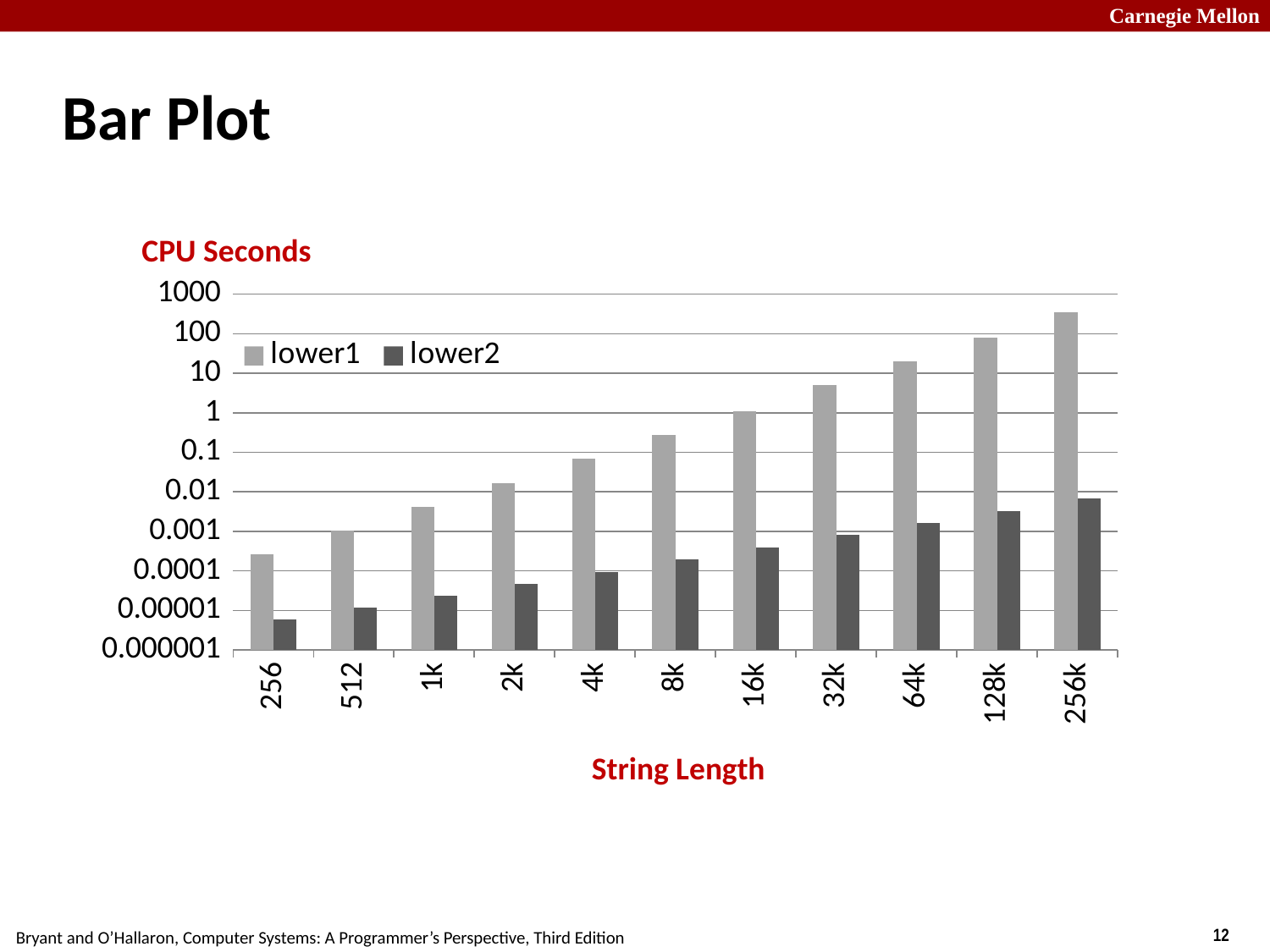
Is the lower1 value for string length 256k greater or less than 100? greater What is the label on the y axis of the chart? CPU Seconds Which string length has the lowest lower2 value? 256 Is the lower1 value for string length 32k greater or less than 10? less What kind of chart is shown on the slide? bar chart Which string length has the highest lower1 value? 256k Do the lower1 values rise or fall as string length increases along the x axis? rise Is the lower2 value for string length 256 greater or less than 0.00001? less How many series does the legend list? 2 At string length 4k, which series has the larger value, lower1 or lower2? lower1 How many string length categories are shown on the x axis? 11